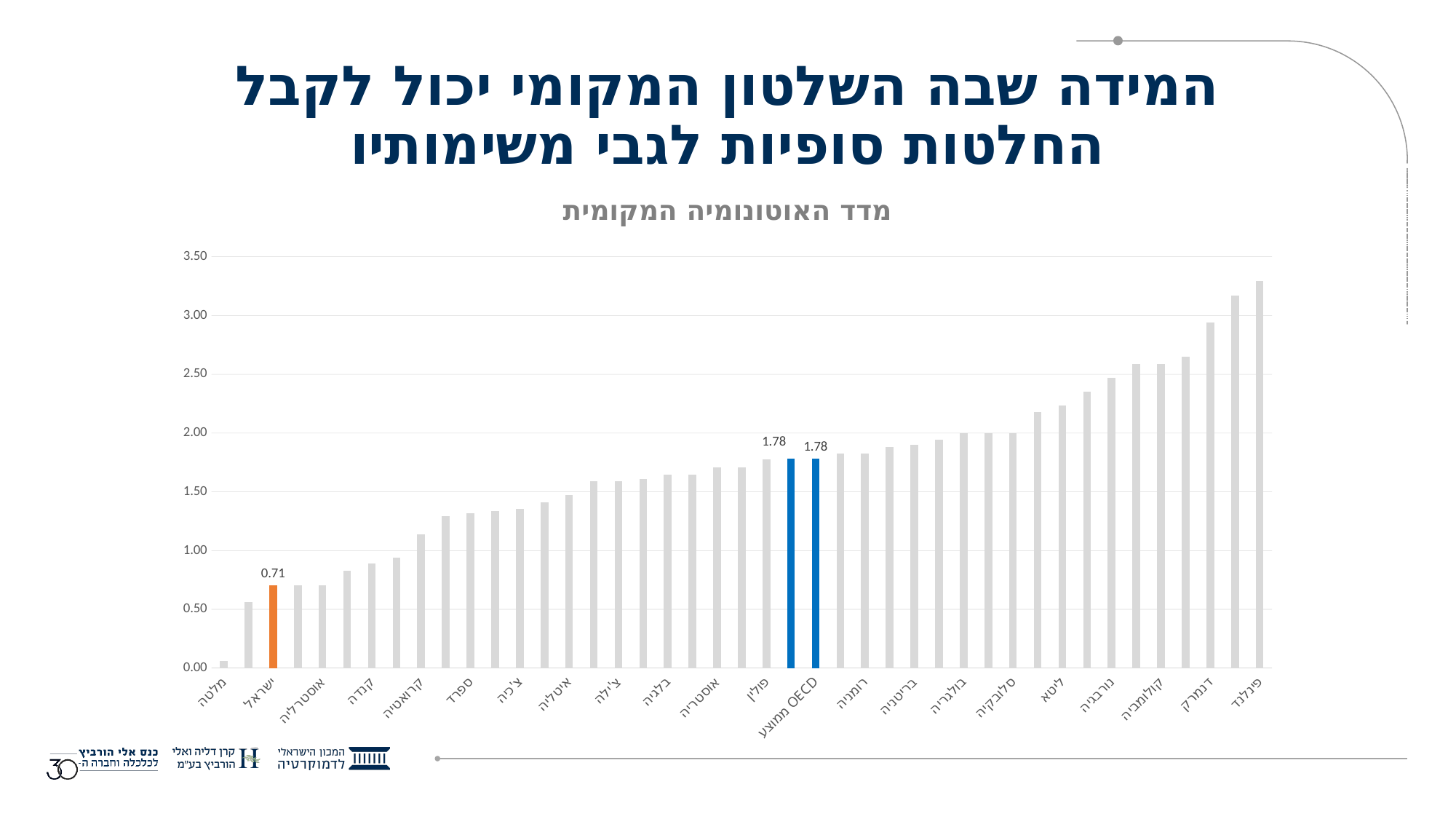
What is the value shown for ממוצע OECD (OECD average)? 1.78 Which country has the highest value on the chart? פינלנד (Finland) Do the values rise or fall moving from left to right along the x axis? rise Is the value for נורבגיה (Norway) greater or less than 2.00? greater What type of chart is shown on the slide? bar chart Is the value for קנדה (Canada) greater or less than 1.00? less What colour is the bar for ישראל (Israel)? orange What is the value of the local autonomy index for ישראל (Israel)? 0.71 Which country has the lowest value on the chart? מלטה (Malta) Which is larger, the value for ישראל (Israel) or the value for ממוצע OECD (OECD average)? ממוצע OECD (OECD average) Is the value for פינלנד (Finland) greater or less than 3.00? greater What is the difference between the OECD average (1.78) and Israel (0.71)? 1.07